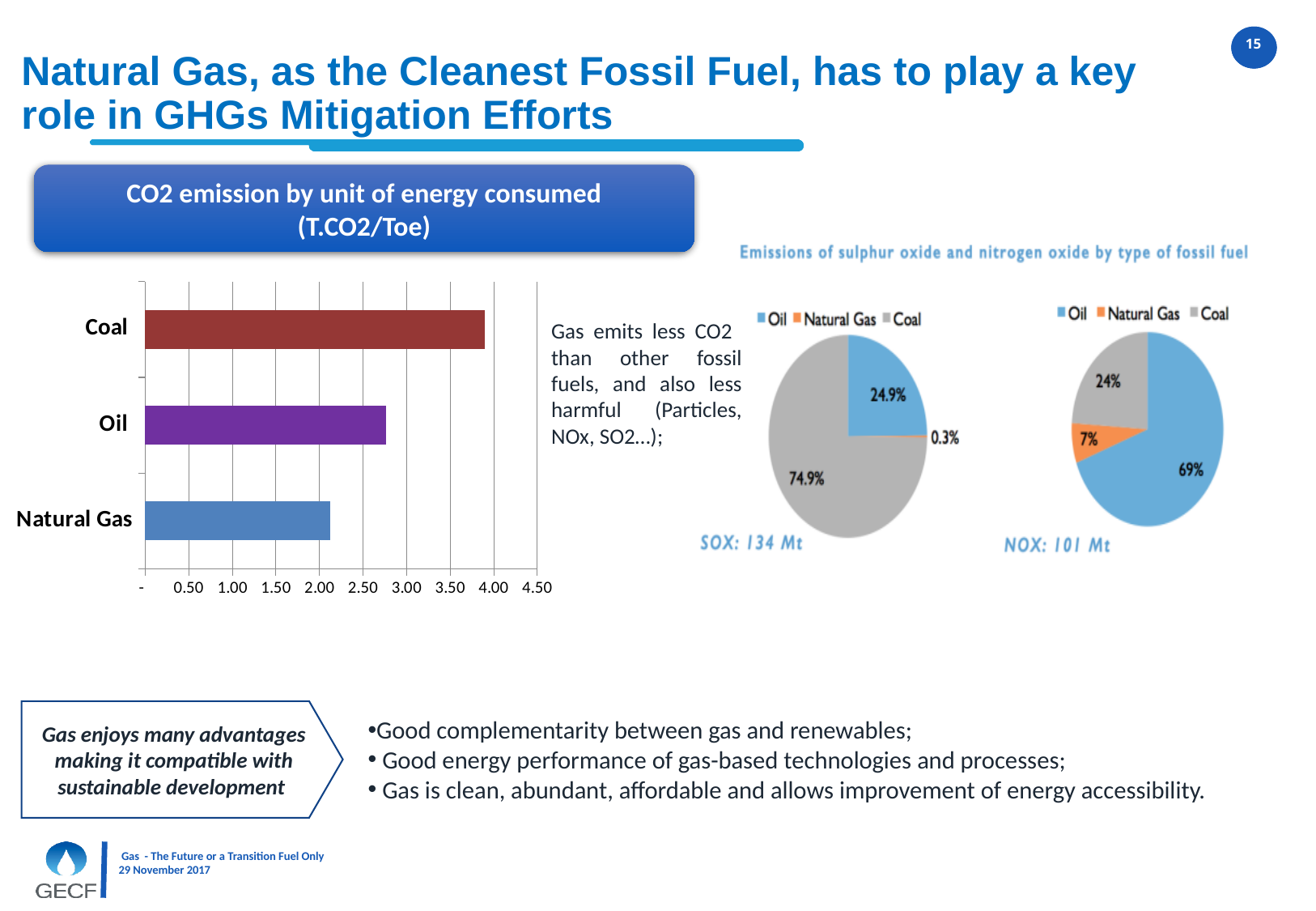
In the 'CO2 emission by unit of energy consumed' chart, how many fuel categories are shown? 3 In the SOX pie chart, what share of emissions comes from Coal? 74.9% How many series does the legend of the SOX pie chart list? 3 In the NOX pie chart, what share of emissions comes from Oil? 69% In the 'CO2 emission by unit of energy consumed' chart, is the value for Oil greater or less than 2.50? greater In the 'CO2 emission by unit of energy consumed' chart, is the value for Natural Gas greater or less than 2.50? less In the 'CO2 emission by unit of energy consumed' chart, which fuel has the lowest value? Natural Gas What kind of chart is the 'CO2 emission by unit of energy consumed' chart? bar chart In the NOX pie chart, what is the difference between the Coal share and the Natural Gas share? 17% In the SOX pie chart, what share of emissions comes from Natural Gas? 0.3% In the 'CO2 emission by unit of energy consumed' chart, which fuel has the highest value? Coal In the 'CO2 emission by unit of energy consumed' chart, is the value for Coal greater or less than 3.50? greater